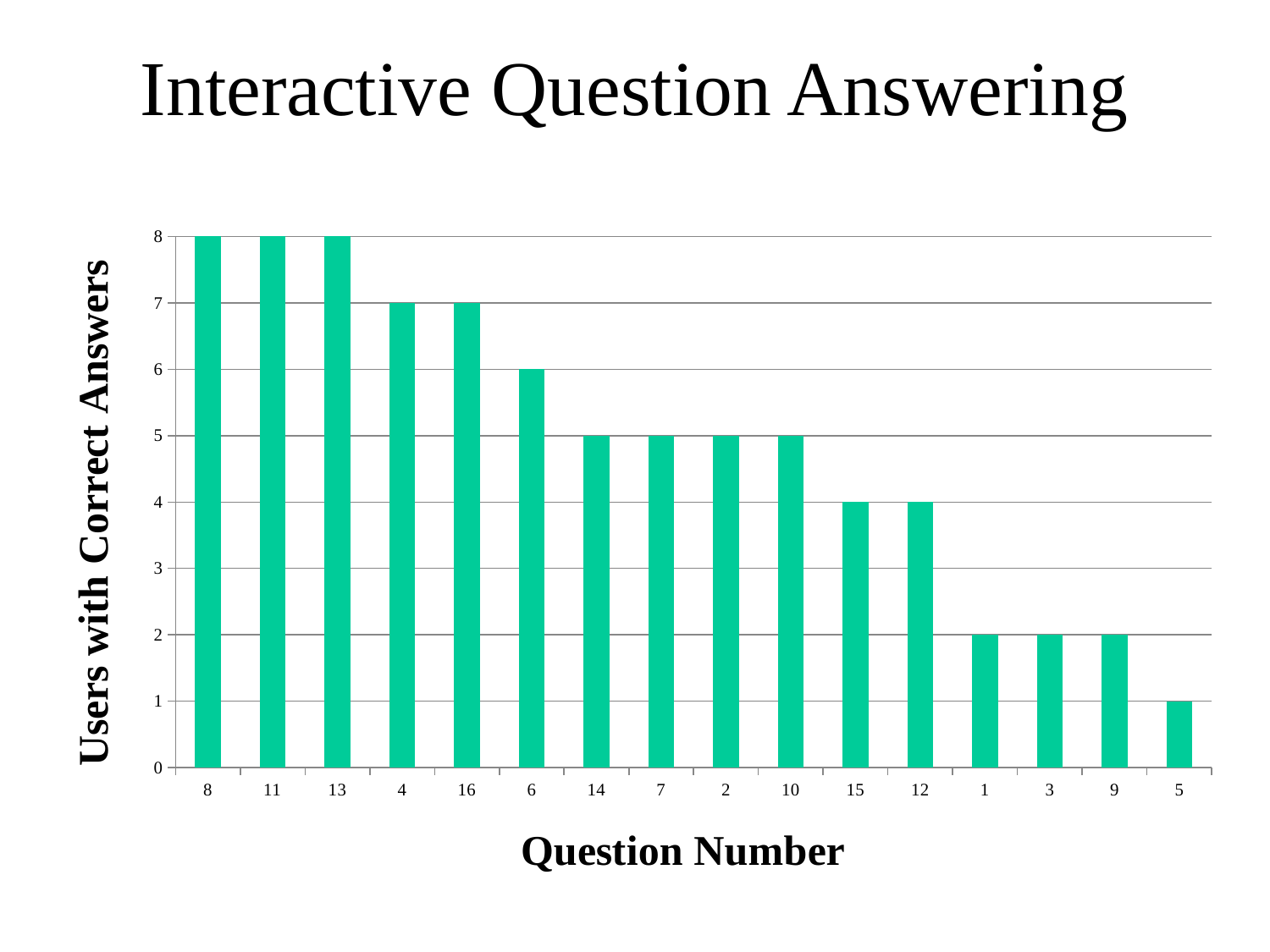
What is the difference between the number of users with correct answers for question 8 and question 5? 7 How many question numbers are shown on the x axis? 16 Do the values rise or fall from left to right along the x axis? fall How many users answered question 12 correctly? 4 What is the difference between the number of users with correct answers for question 4 and question 15? 3 What is the label of the y axis? Users with Correct Answers How many users answered question 5 correctly? 1 How many users answered question 6 correctly? 6 How many users answered question 8 correctly? 8 What kind of chart is shown on the slide? bar chart Which has more users with correct answers, question 16 or question 1? question 16 Which question number has the fewest users with correct answers? 5